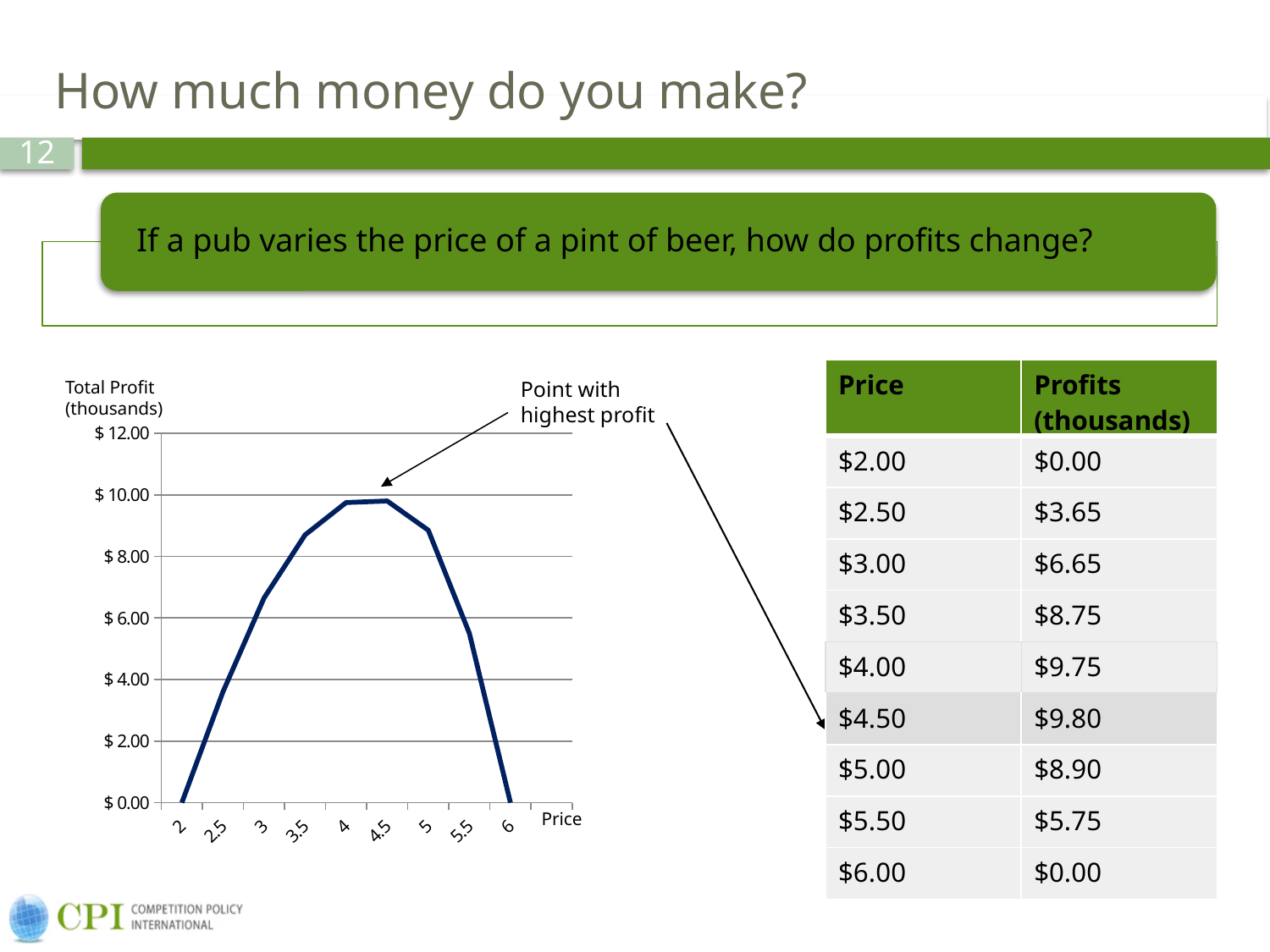
What kind of chart is shown on the slide? Line chart What is the difference in profit (thousands) between a price of $4.50 and a price of $2.50? $6.15 What is the total profit (thousands) when the price is $5.50? $5.75 What is the difference in profit (thousands) between a price of $5.00 and a price of $5.50? $3.15 How does total profit change as price rises from $2 to $6? It rises to a peak at $4.50, then falls How many price points are plotted on the line chart? 9 Is the profit at a price of $3.50 greater or less than $8.00? greater At which price is total profit highest? $4.50 Which price gives the larger profit, $3.50 or $5.00? $5.00 What is the label on the vertical axis of the chart? Total Profit (thousands) What is the total profit (thousands) when the price is $3.00? $6.65 What is the total profit (thousands) when the price is $4.50? $9.80